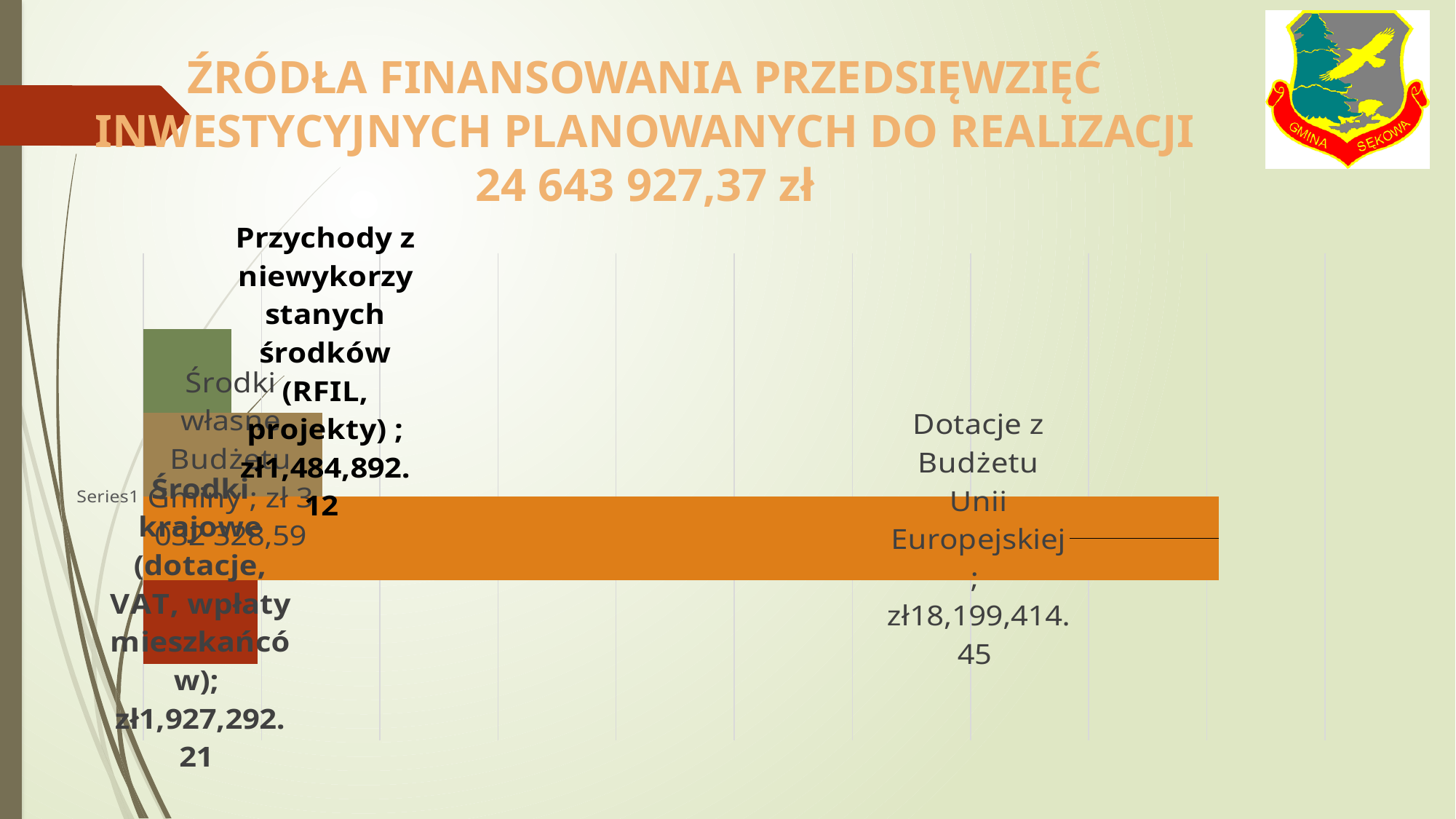
What is the value for Środki krajowe (dotacje, VAT, wpłaty mieszkańców)? zł1,927,292.21 How many funding sources (bars) are shown in the chart? 4 Which funding source has the highest value? Dotacje z Budżetu Unii Europejskiej What kind of chart is shown on the slide? bar chart Which funding source has the lowest value? Przychody z niewykorzystanych stanów środków (RFIL, projekty) What is the value for Przychody z niewykorzystanych stanów środków (RFIL, projekty)? zł1,484,892.12 What is the value for Dotacje z Budżetu Unii Europejskiej? zł18,199,414.45 Which is larger: Środki własne Budżetu Gminy or Dotacje z Budżetu Unii Europejskiej? Dotacje z Budżetu Unii Europejskiej What is the value for Środki własne Budżetu Gminy? zł 3 032 328,59 Which is larger: Środki krajowe or Przychody z niewykorzystanych stanów środków (RFIL, projekty)? Środki krajowe What is the difference between Środki krajowe and Przychody z niewykorzystanych stanów środków (RFIL, projekty)? zł442,400.09 What total amount is given in the slide title? 24 643 927,37 zł